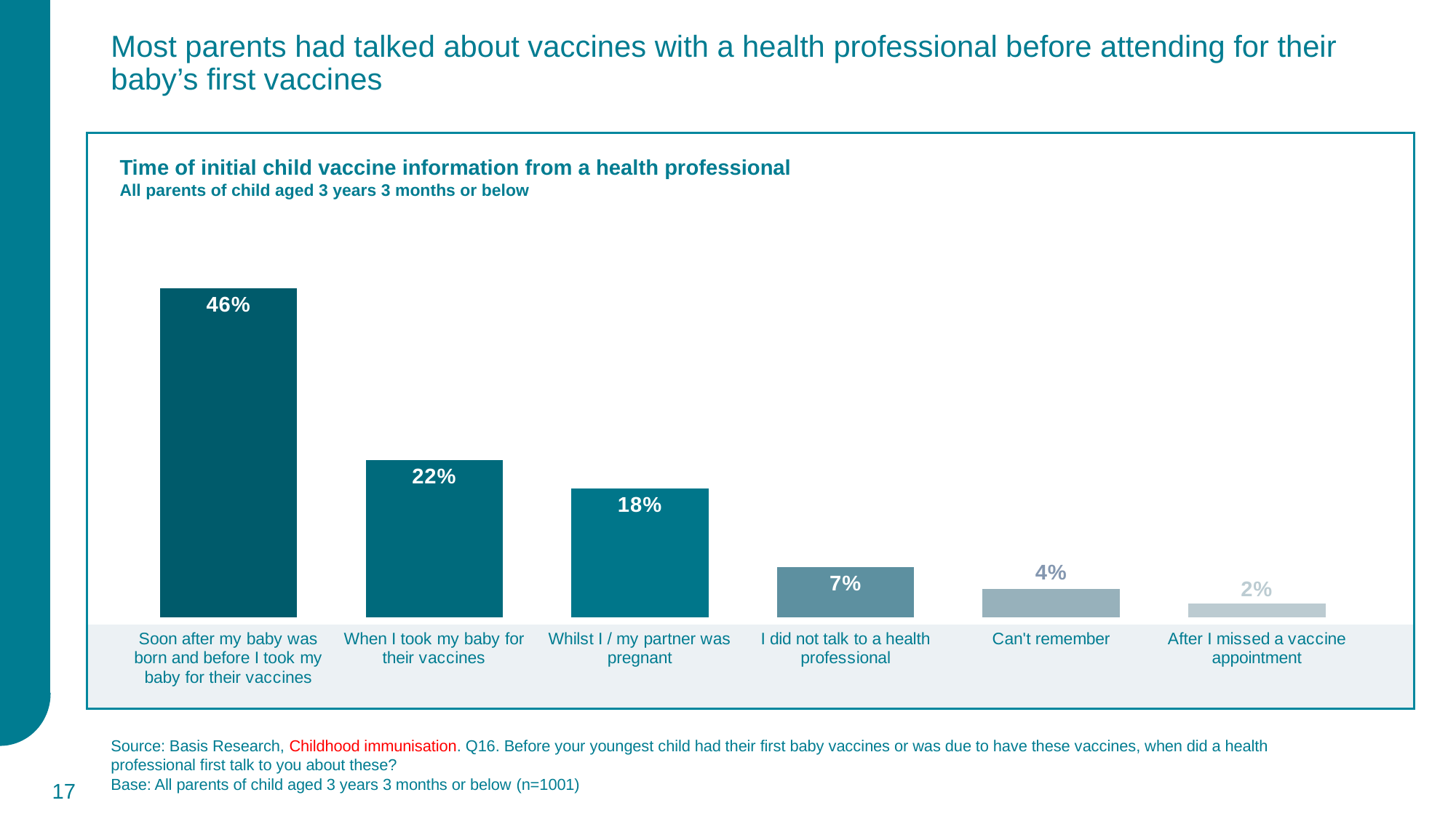
What is the value for 'When I took my baby for their vaccines'? 22% What is the title of the chart? Time of initial child vaccine information from a health professional What percentage of parents first received child vaccine information from a health professional whilst they or their partner was pregnant? 18% Which is larger: the value for 'Whilst I / my partner was pregnant' or the value for 'I did not talk to a health professional'? Whilst I / my partner was pregnant Do the values rise or fall moving from left to right across the categories? Fall Which category has the highest value? Soon after my baby was born and before I took my baby for their vaccines What kind of chart is shown on the slide? Bar chart How many categories are shown in the chart? 6 Which category has the lowest value? After I missed a vaccine appointment What is the difference between the value for 'Soon after my baby was born and before I took my baby for their vaccines' and the value for 'When I took my baby for their vaccines'? 24% What is the value for 'Can't remember'? 4% What percentage of parents said they did not talk to a health professional? 7%